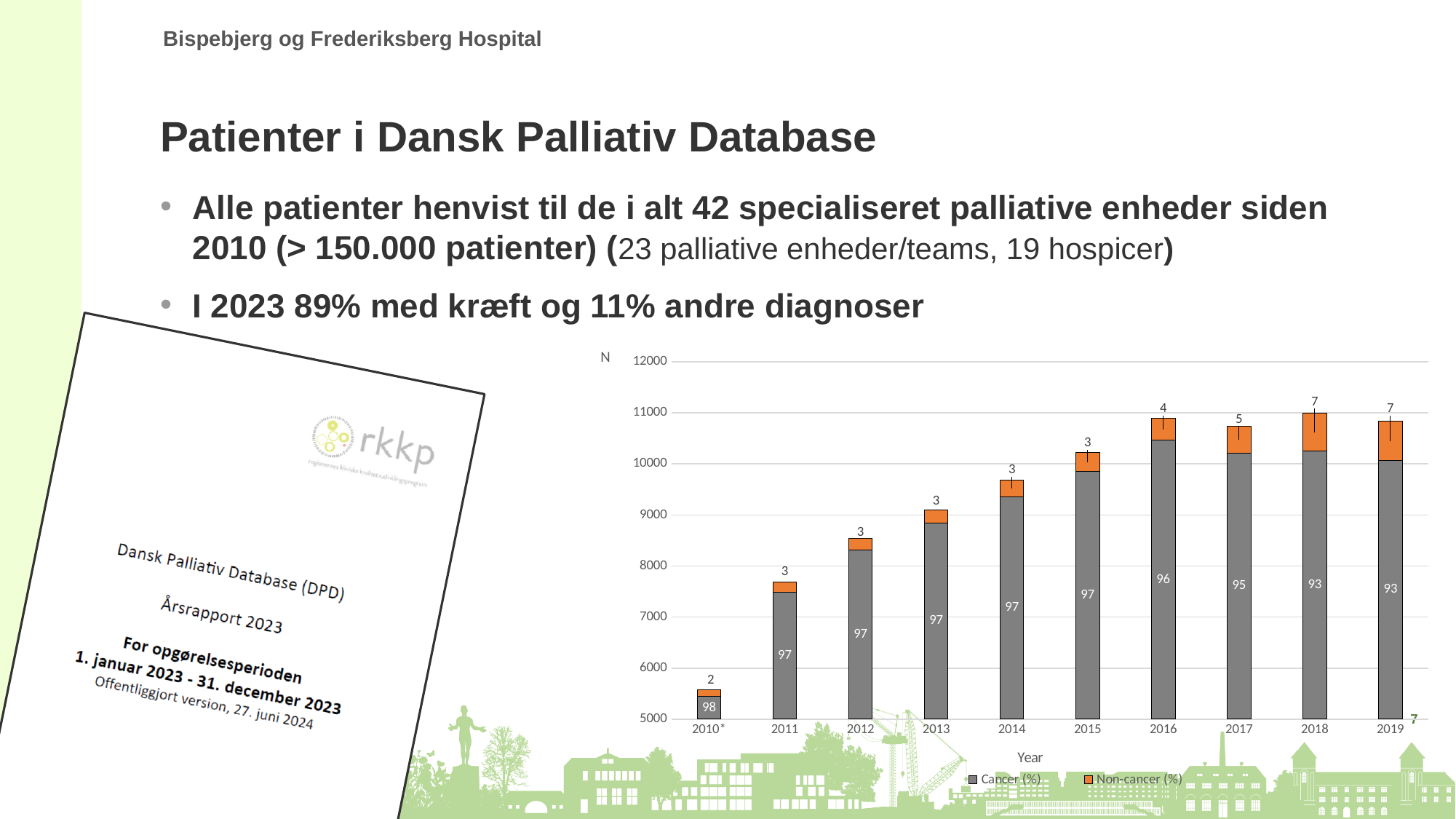
How many years are shown on the x axis of the chart? 10 What is the Non-cancer (%) label for 2016 in the chart? 4 Is the total bar height (N) for 2010* greater or less than 6000? less What is the Cancer (%) label for 2019 in the chart? 93 How many series does the chart legend list? 2 What is the Cancer (%) label for 2010* in the chart? 98 What is the difference between the Cancer (%) label for 2010* and for 2019? 5 Is the total bar height (N) for 2019 greater or less than 10000? greater Which year has the lowest total bar (N) in the chart? 2010* What kind of chart is shown on the slide? stacked bar chart What is the Non-cancer (%) label for 2017 in the chart? 5 Which year has the highest Cancer (%) label in the chart? 2010*